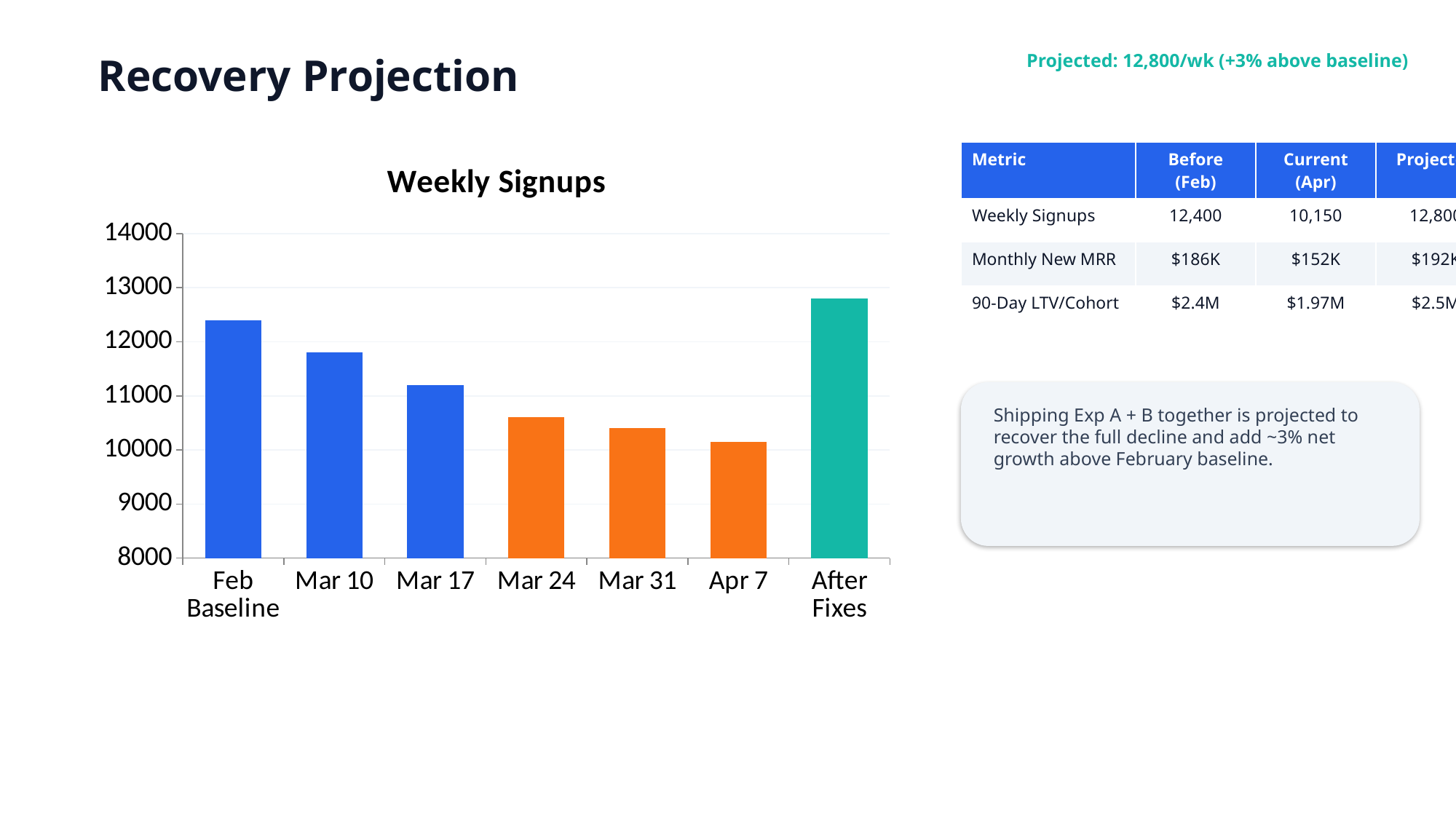
What is the title of the chart? Weekly Signups Is the value for After Fixes greater or less than 13000? less Which category has the highest bar in the Weekly Signups chart? After Fixes What colour is the After Fixes bar? teal How many bars are shown in the Weekly Signups chart? 7 What kind of chart is the Weekly Signups chart? bar chart Is the value for Feb Baseline greater or less than 12000? greater Is the value for Mar 31 greater or less than 11000? less Which category has the lowest bar in the Weekly Signups chart? Apr 7 Which is larger, the value for Mar 10 or the value for Mar 24? Mar 10 Do the weekly signup values rise or fall from Feb Baseline through Apr 7? fall